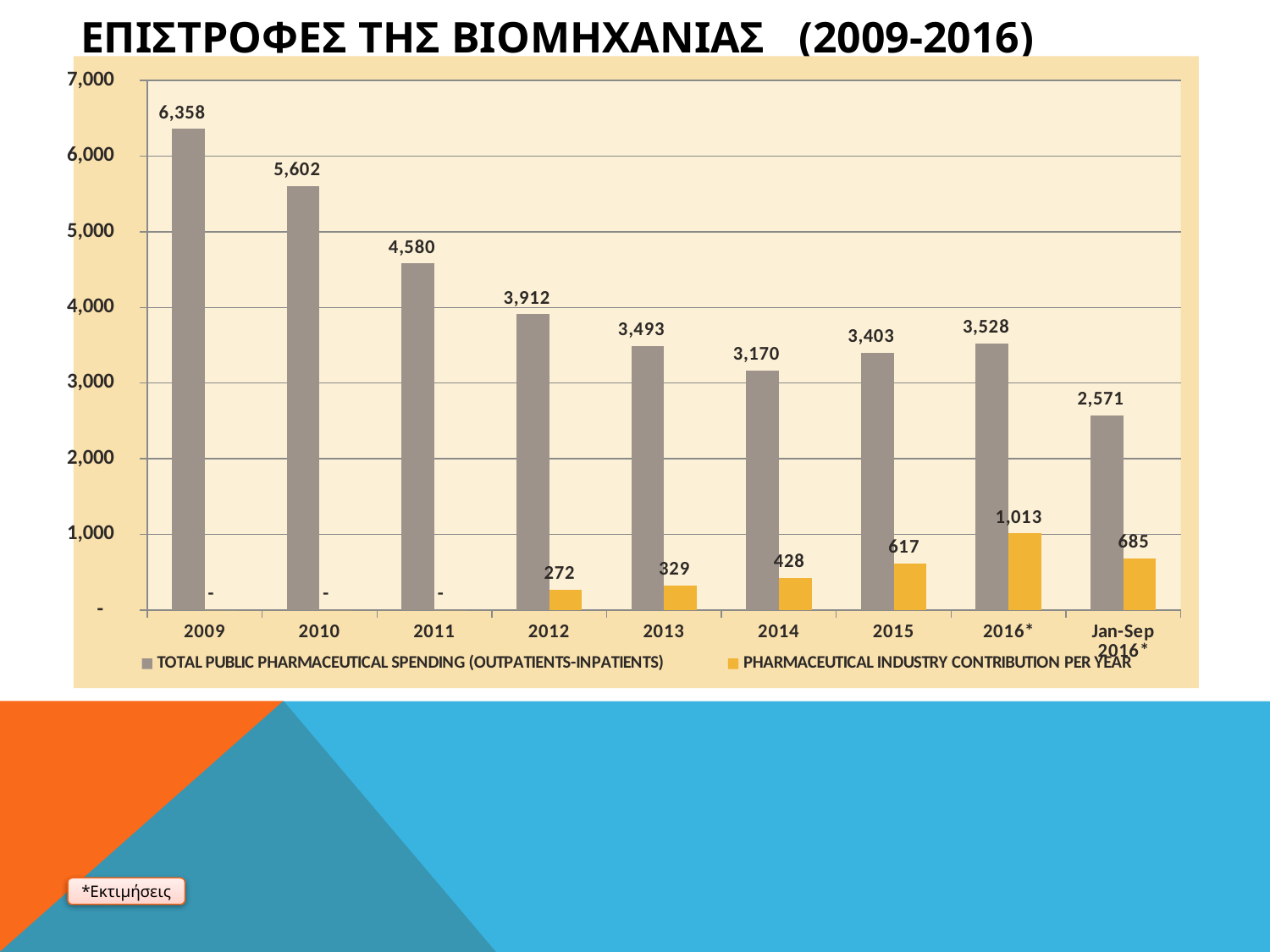
How many categories are shown on the x axis? 9 What kind of chart is shown on the slide? bar chart Which category has the highest PHARMACEUTICAL INDUSTRY CONTRIBUTION PER YEAR? 2016* What is the value of TOTAL PUBLIC PHARMACEUTICAL SPENDING (OUTPATIENTS-INPATIENTS) for 2009? 6,358 Which year has the highest TOTAL PUBLIC PHARMACEUTICAL SPENDING (OUTPATIENTS-INPATIENTS)? 2009 Which is larger, TOTAL PUBLIC PHARMACEUTICAL SPENDING in 2014 or in 2015? 2015 What is the value of PHARMACEUTICAL INDUSTRY CONTRIBUTION PER YEAR for 2015? 617 What is the difference between TOTAL PUBLIC PHARMACEUTICAL SPENDING in 2009 and 2010? 756 How many series does the legend list? 2 What is the value of TOTAL PUBLIC PHARMACEUTICAL SPENDING (OUTPATIENTS-INPATIENTS) for Jan-Sep 2016*? 2,571 What is the difference between PHARMACEUTICAL INDUSTRY CONTRIBUTION PER YEAR in 2016* and 2015? 396 Is the TOTAL PUBLIC PHARMACEUTICAL SPENDING for 2011 greater or less than 5,000? less